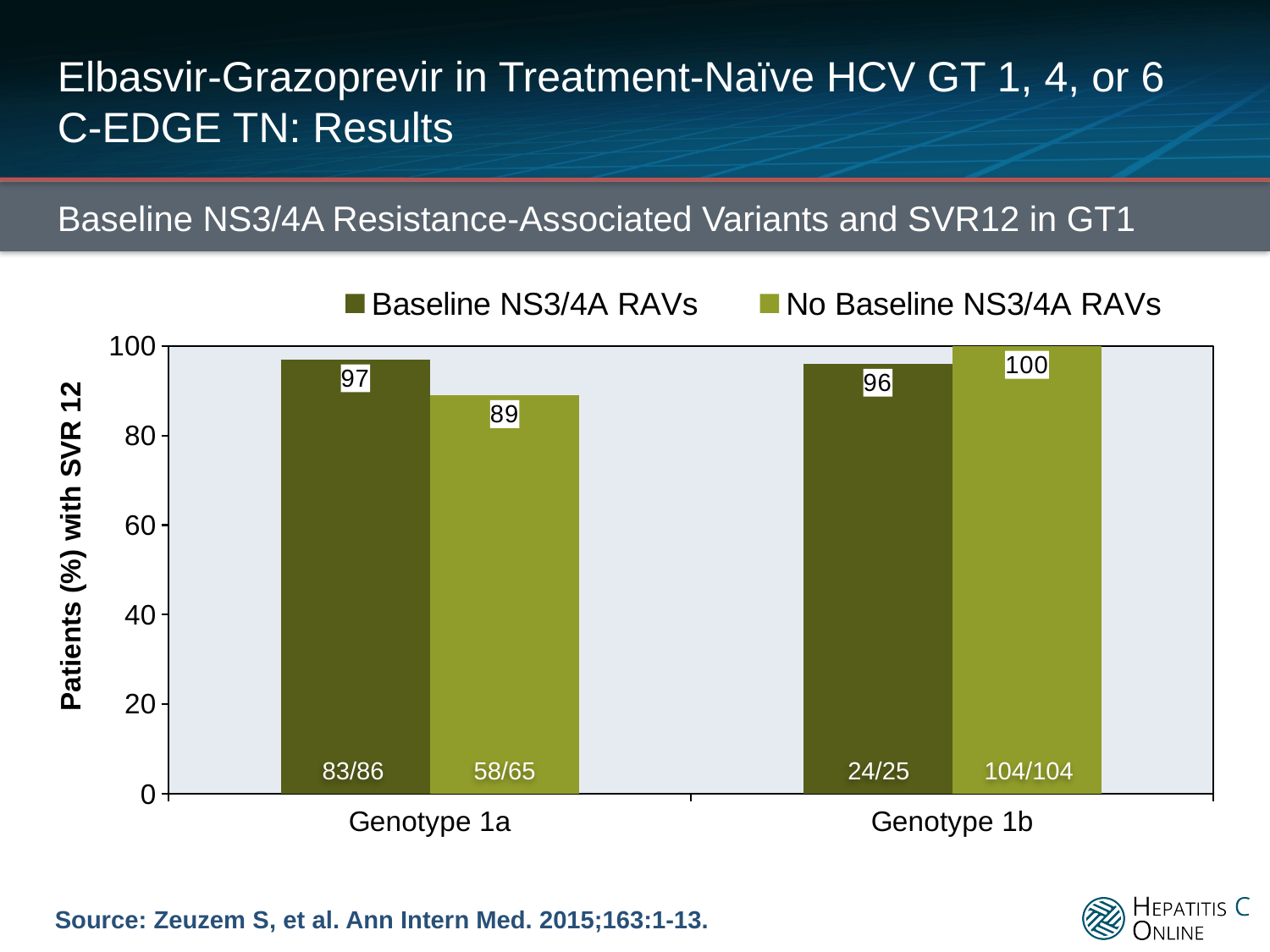
What is the SVR12 rate for patients with Baseline NS3/4A RAVs in Genotype 1a? 97 In Genotype 1b, which group has the higher SVR12 rate: Baseline NS3/4A RAVs or No Baseline NS3/4A RAVs? No Baseline NS3/4A RAVs How many genotype categories are shown on the x axis? 2 What is the SVR12 rate for patients with No Baseline NS3/4A RAVs in Genotype 1a? 89 What is the SVR12 rate for patients with No Baseline NS3/4A RAVs in Genotype 1b? 100 What is the label of the y axis? Patients (%) with SVR 12 How many patients achieved SVR12 out of the total in the Baseline NS3/4A RAVs group for Genotype 1b? 24/25 How many series does the legend list? 2 Which bar has the lowest SVR12 rate? No Baseline NS3/4A RAVs, Genotype 1a What is the difference in SVR12 rate between the Baseline NS3/4A RAVs and No Baseline NS3/4A RAVs groups in Genotype 1a? 8 Which bar has the highest SVR12 rate? No Baseline NS3/4A RAVs, Genotype 1b What kind of chart is shown on the slide? Bar chart